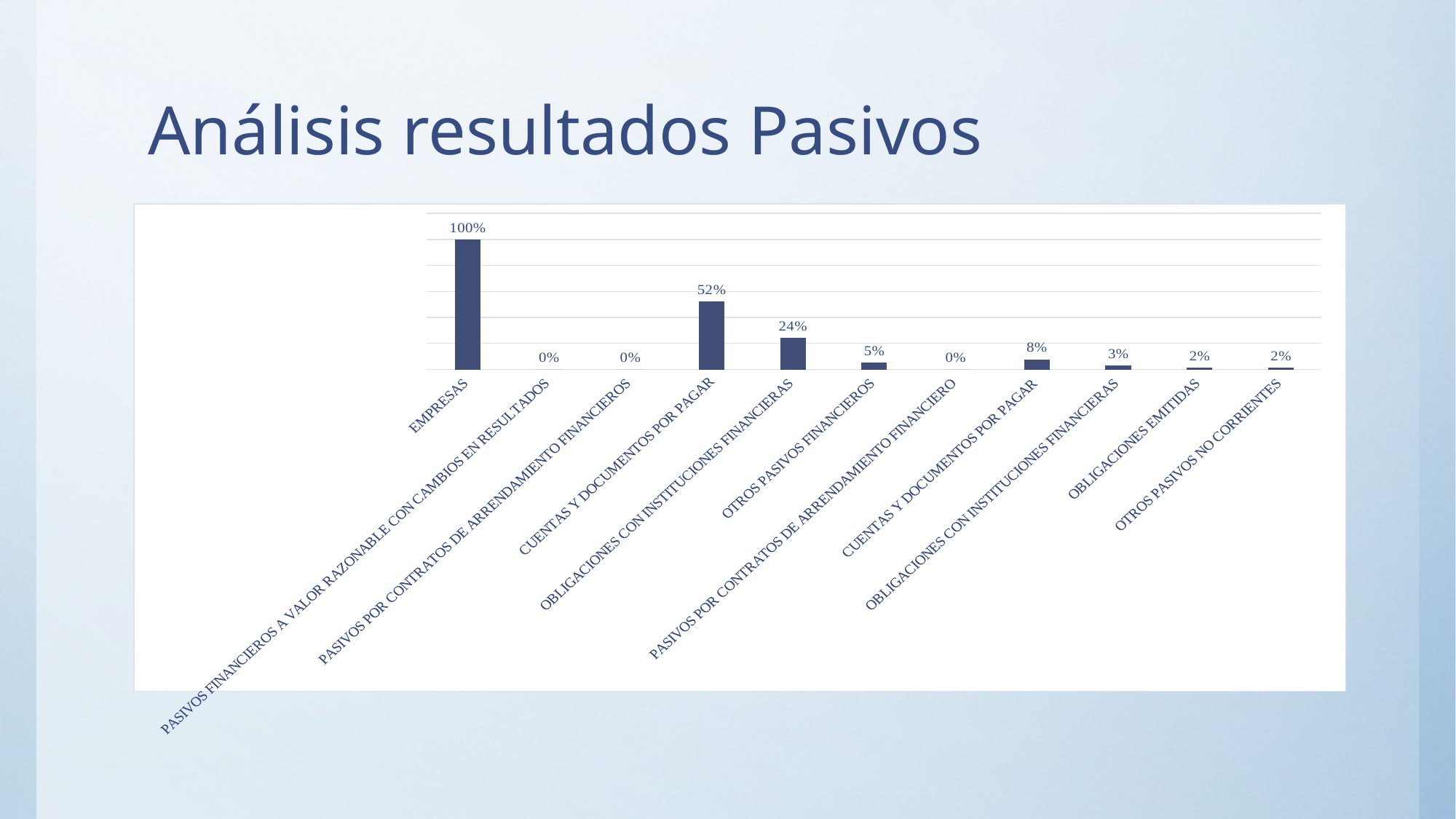
What kind of chart is shown on the slide? Bar chart What is the difference between the value for EMPRESAS and the first CUENTAS Y DOCUMENTOS POR PAGAR bar (52%)? 48% Which category has the highest value? EMPRESAS What is the value for OTROS PASIVOS NO CORRIENTES? 2% What is the value for OTROS PASIVOS FINANCIEROS? 5% What is the value for the second OBLIGACIONES CON INSTITUCIONES FINANCIERAS bar (ninth from the left)? 3% What is the value for OBLIGACIONES EMITIDAS? 2% Which is larger: the value for OTROS PASIVOS FINANCIEROS or the second CUENTAS Y DOCUMENTOS POR PAGAR bar (8%)? The second CUENTAS Y DOCUMENTOS POR PAGAR bar (8%) What is the difference between the first OBLIGACIONES CON INSTITUCIONES FINANCIERAS bar (24%) and OTROS PASIVOS FINANCIEROS? 19% How many categories are shown on the x axis? 11 What is the value for EMPRESAS? 100% What is the value for the first CUENTAS Y DOCUMENTOS POR PAGAR bar (fourth from the left)? 52%